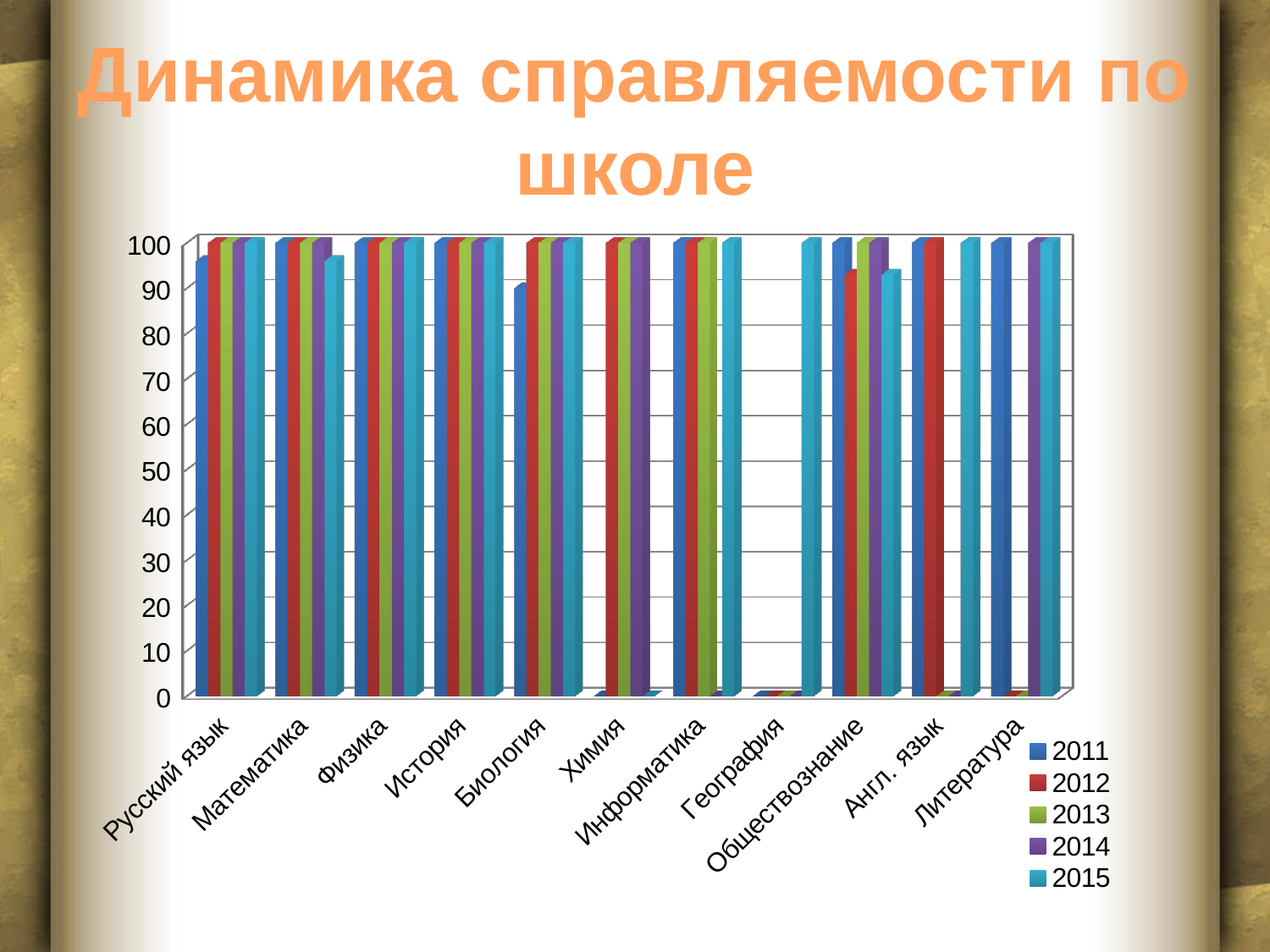
For Биология, which year has the lowest value among the bars shown? 2011 How many series does the legend list? 5 What kind of chart is shown on the slide? bar chart Is the value for Биология in 2011 greater or less than 95? less What is the title of the chart on the slide? Динамика справляемости по школе Is the value for Русский язык in 2011 greater or less than 90? greater Which years are listed in the legend? 2011, 2012, 2013, 2014, 2015 How many subject categories are shown on the x axis? 11 For Математика, which year has the lowest value? 2015 Is the value for Математика in 2015 greater or less than 90? greater For Биология, which is larger: the value for 2011 or the value for 2012? 2012